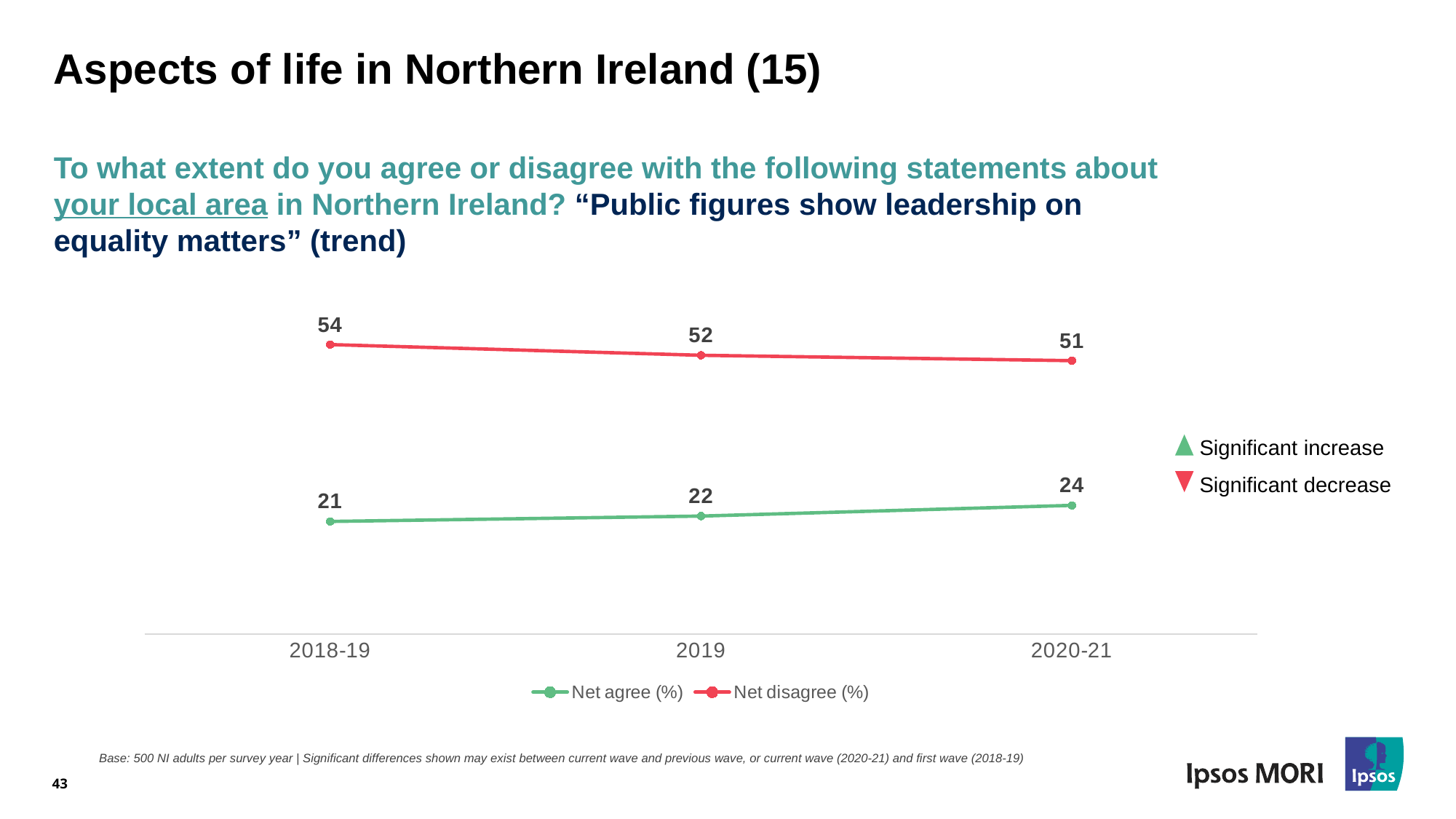
What is the Net disagree (%) value for 2020-21? 51 Which is larger in 2019, Net agree (%) or Net disagree (%)? Net disagree (%) What is the Net disagree (%) value for 2019? 52 In which year is Net disagree (%) lowest? 2020-21 Does Net disagree (%) rise or fall from 2018-19 to 2020-21? Fall In which year is Net agree (%) highest? 2020-21 How many series does the chart legend list? 2 How many survey years are plotted on the x axis? 3 By how much did Net agree (%) change from 2018-19 to 2020-21? 3 What is the Net agree (%) value for 2018-19? 21 What kind of chart is shown on the slide? Line chart What is the difference between Net disagree (%) and Net agree (%) in 2018-19? 33